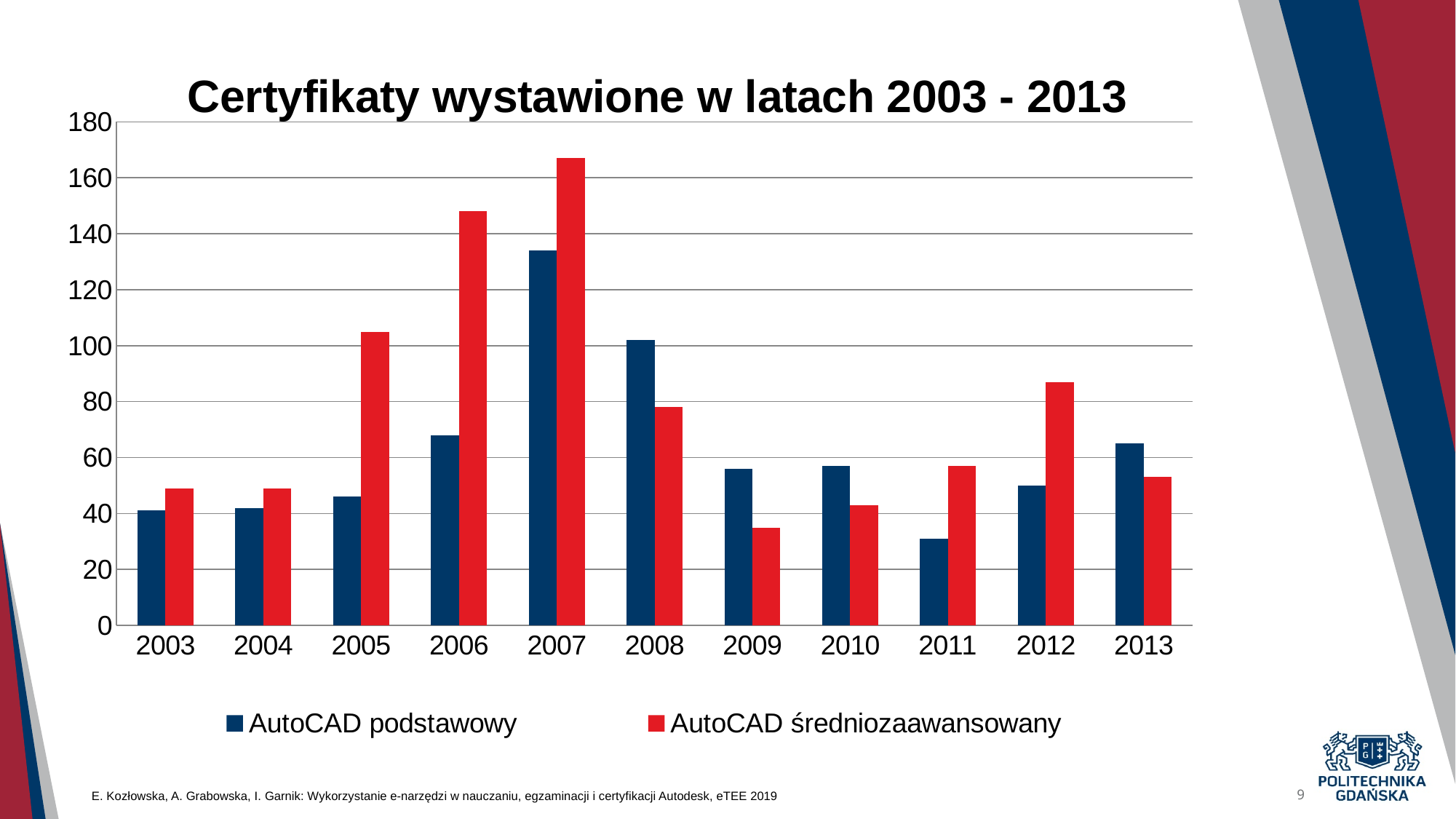
What is the title of the chart? Certyfikaty wystawione w latach 2003 - 2013 In which year is the value for AutoCAD podstawowy highest? 2007 What kind of chart is shown on the slide? bar chart Is the value for AutoCAD średniozaawansowany in 2006 greater or less than 140? greater How many years are shown on the x axis? 11 In 2005, which series has the larger value, AutoCAD podstawowy or AutoCAD średniozaawansowany? AutoCAD średniozaawansowany In which year is the value for AutoCAD średniozaawansowany highest? 2007 In which year is the value for AutoCAD podstawowy lowest? 2011 How many series does the legend list? 2 In which year is the value for AutoCAD średniozaawansowany lowest? 2009 Is the value for AutoCAD podstawowy in 2011 greater or less than 40? less Is the value for AutoCAD średniozaawansowany in 2007 greater or less than 160? greater